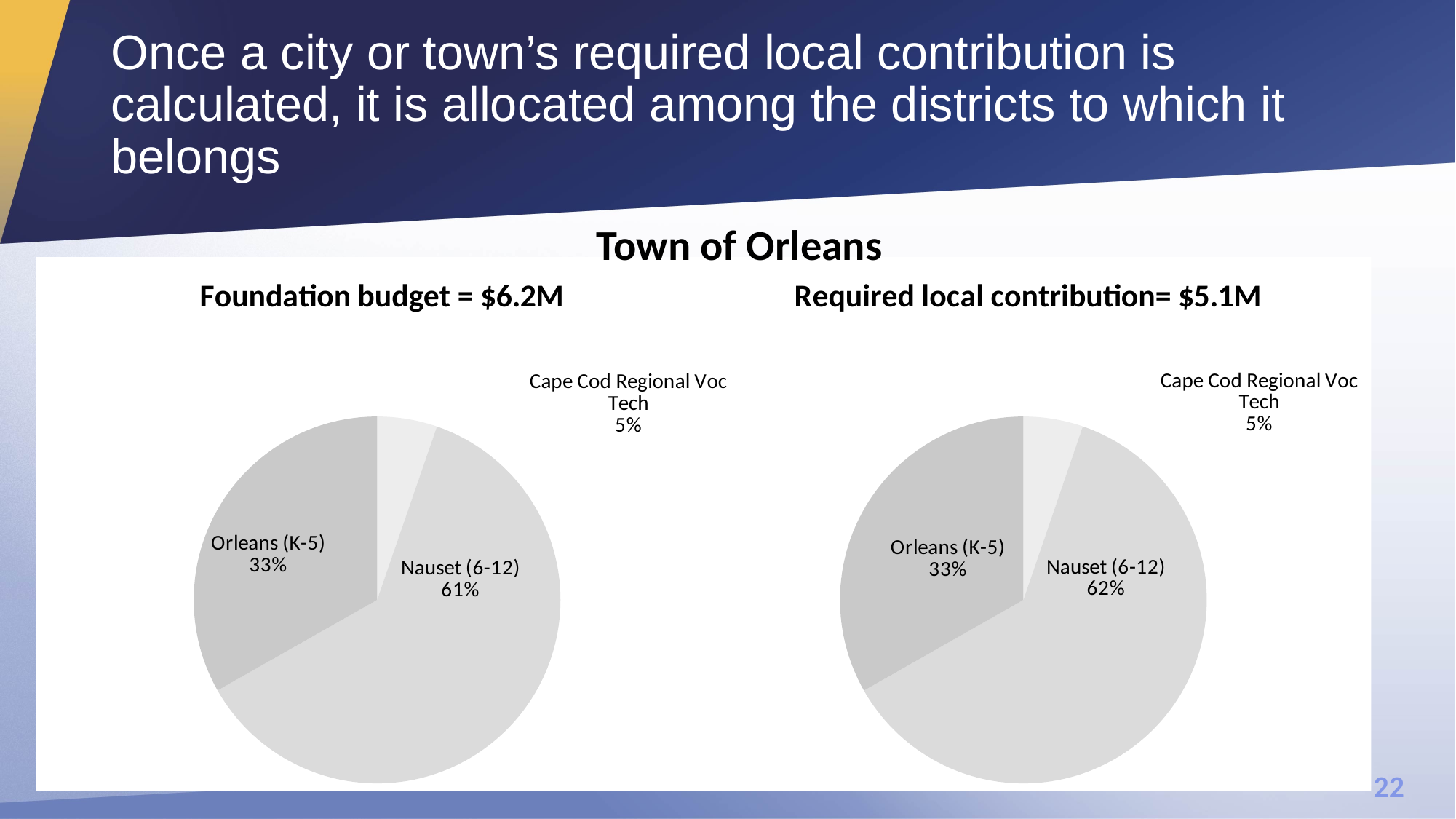
In the Required local contribution= $5.1M chart, which is larger, the Orleans (K-5) share or the Cape Cod Regional Voc Tech share? Orleans (K-5) In the Required local contribution= $5.1M chart, what share does Nauset (6-12) have? 62% In the Foundation budget = $6.2M chart, which district has the largest slice? Nauset (6-12) Which town do the two charts describe? Town of Orleans How many slices does the Foundation budget = $6.2M chart have? 3 What type of chart is the Required local contribution= $5.1M chart? Pie chart In the Foundation budget = $6.2M chart, what is the difference between the Nauset (6-12) share and the Orleans (K-5) share? 28% In the Foundation budget = $6.2M chart, what share does Nauset (6-12) have? 61% In the Required local contribution= $5.1M chart, which district has the smallest slice? Cape Cod Regional Voc Tech In the Foundation budget = $6.2M chart, what share does Orleans (K-5) have? 33% What is the title of the chart on the left? Foundation budget = $6.2M